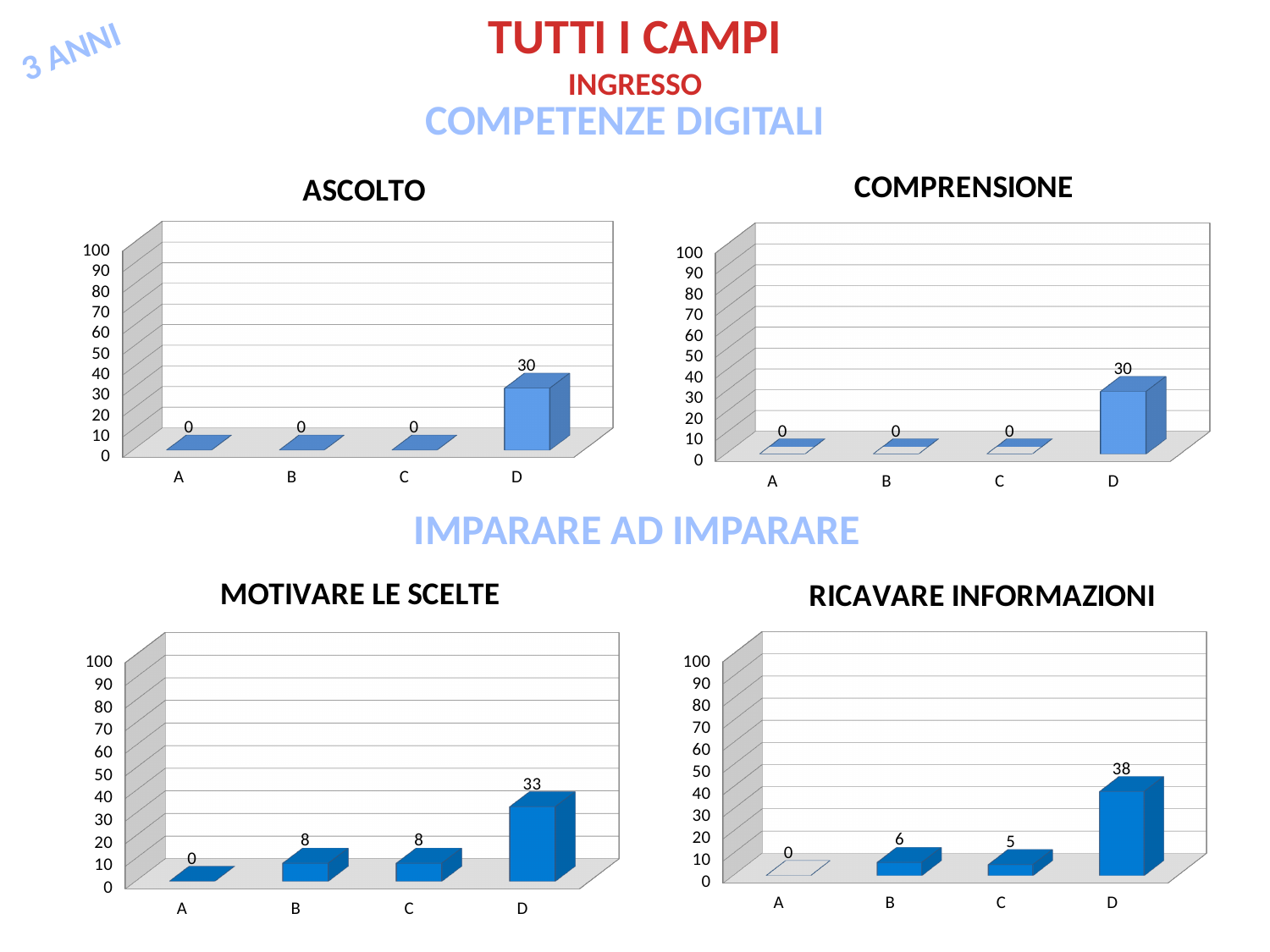
What kind of chart is the COMPRENSIONE chart? bar chart In the RICAVARE INFORMAZIONI chart, what is the value for category C? 5 In the MOTIVARE LE SCELTE chart, is the value for D greater or less than 20? greater In the RICAVARE INFORMAZIONI chart, what is the difference between the values for D and B? 32 How many categories are shown on the x axis of the ASCOLTO chart? 4 In the MOTIVARE LE SCELTE chart, which category has the lowest value? A In the ASCOLTO chart, what is the value for category D? 30 In the RICAVARE INFORMAZIONI chart, which is larger, the value for B or the value for C? B In the MOTIVARE LE SCELTE chart, what is the value for category B? 8 In the RICAVARE INFORMAZIONI chart, which category has the highest value? D In the COMPRENSIONE chart, what is the value for category D? 30 In the MOTIVARE LE SCELTE chart, what is the difference between the values for D and C? 25